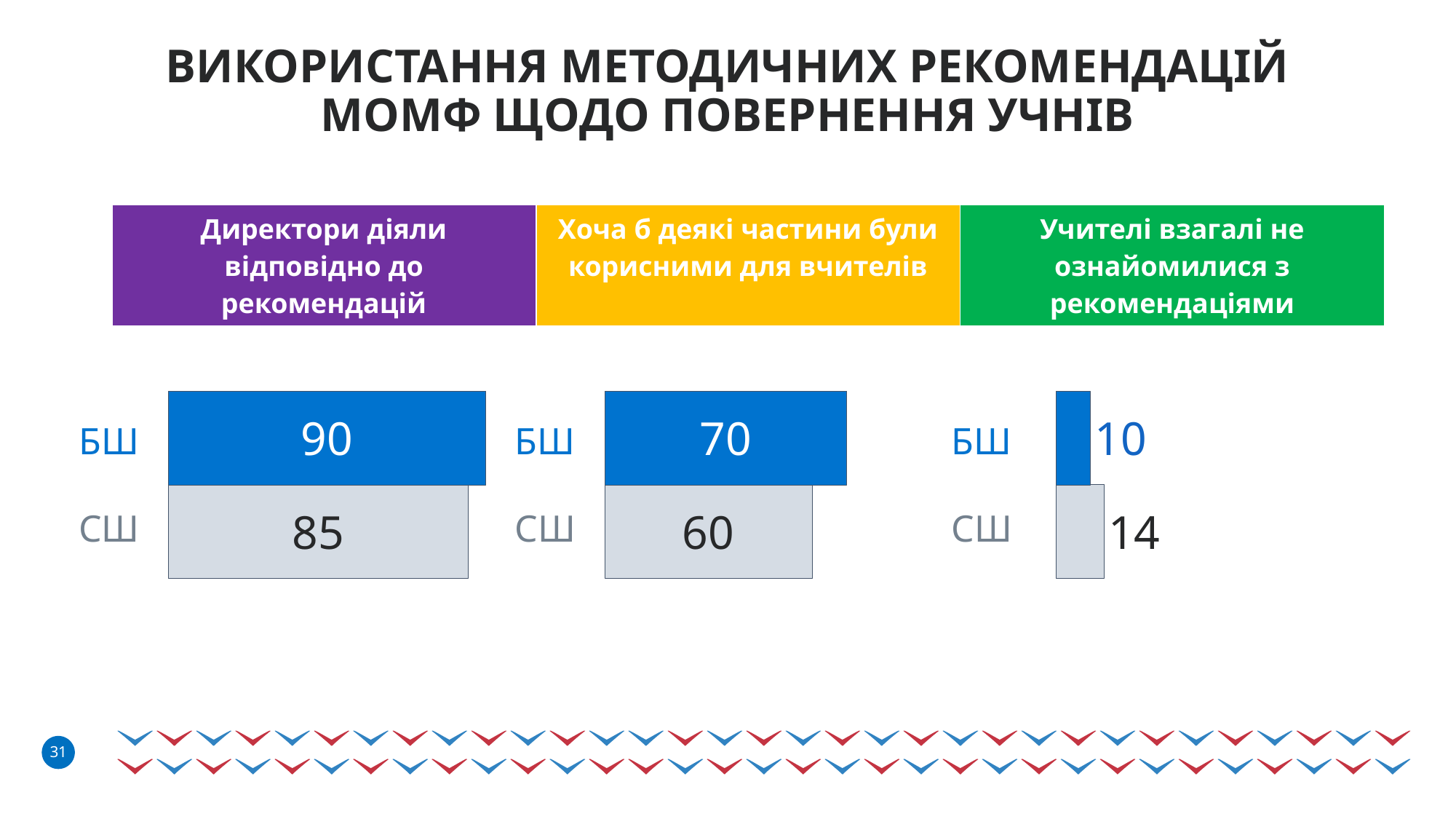
In the left chart ("Директори діяли відповідно до рекомендацій"), what is the value for СШ? 85 In the left chart ("Директори діяли відповідно до рекомендацій"), what colour is the БШ bar? Blue How many bars does the middle chart ("Хоча б деякі частини були корисними для вчителів") show? 2 In the right chart ("Учителі взагалі не ознайомилися з рекомендаціями"), what is the value for СШ? 14 In the right chart ("Учителі взагалі не ознайомилися з рекомендаціями"), what is the difference between the СШ and БШ values? 4 What type of chart is the left chart ("Директори діяли відповідно до рекомендацій")? Bar chart In the right chart ("Учителі взагалі не ознайомилися з рекомендаціями"), which category has the higher value, БШ or СШ? СШ In the middle chart ("Хоча б деякі частини були корисними для вчителів"), what is the difference between the БШ and СШ values? 10 In the left chart ("Директори діяли відповідно до рекомендацій"), what is the value for БШ? 90 In the left chart ("Директори діяли відповідно до рекомендацій"), what is the difference between the БШ and СШ values? 5 In the middle chart ("Хоча б деякі частини були корисними для вчителів"), what is the value for БШ? 70 In the middle chart ("Хоча б деякі частини були корисними для вчителів"), what is the value for СШ? 60